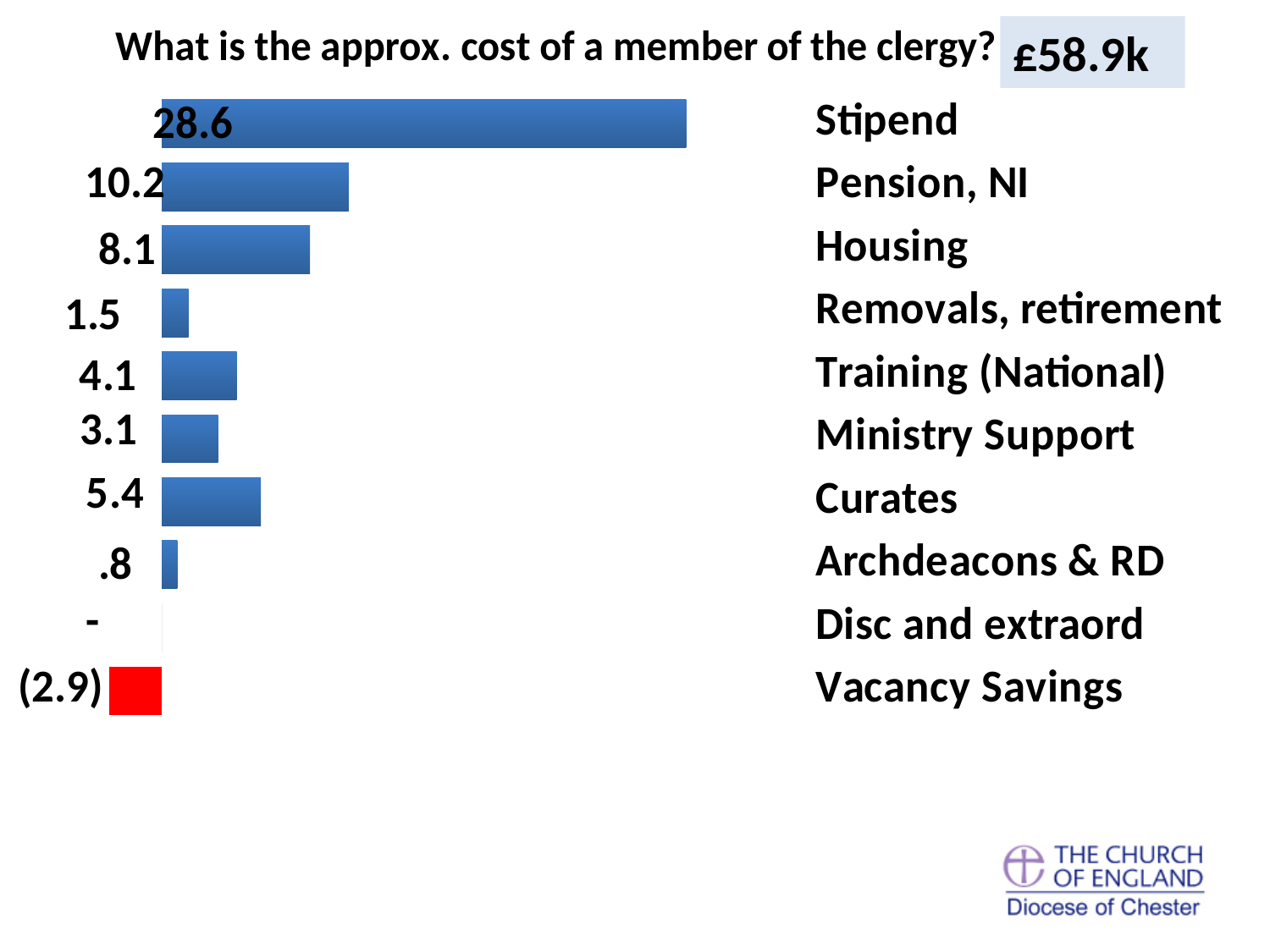
What kind of chart is shown on the slide? Bar chart What approximate total cost of a member of the clergy is shown at the top of the slide? £58.9k Which category has the highest value? Stipend How many categories are listed in the chart? 10 What is the value shown for Archdeacons & RD? .8 What is the difference between the values for Stipend and Pension, NI? 18.4 What is the value shown for Pension, NI? 10.2 What is the value shown for Stipend? 28.6 What is the value shown for Vacancy Savings? (2.9) Which category is shown with a negative value in a red bar? Vacancy Savings Which is larger, the value for Curates or the value for Training (National)? Curates What is the value shown for Housing? 8.1